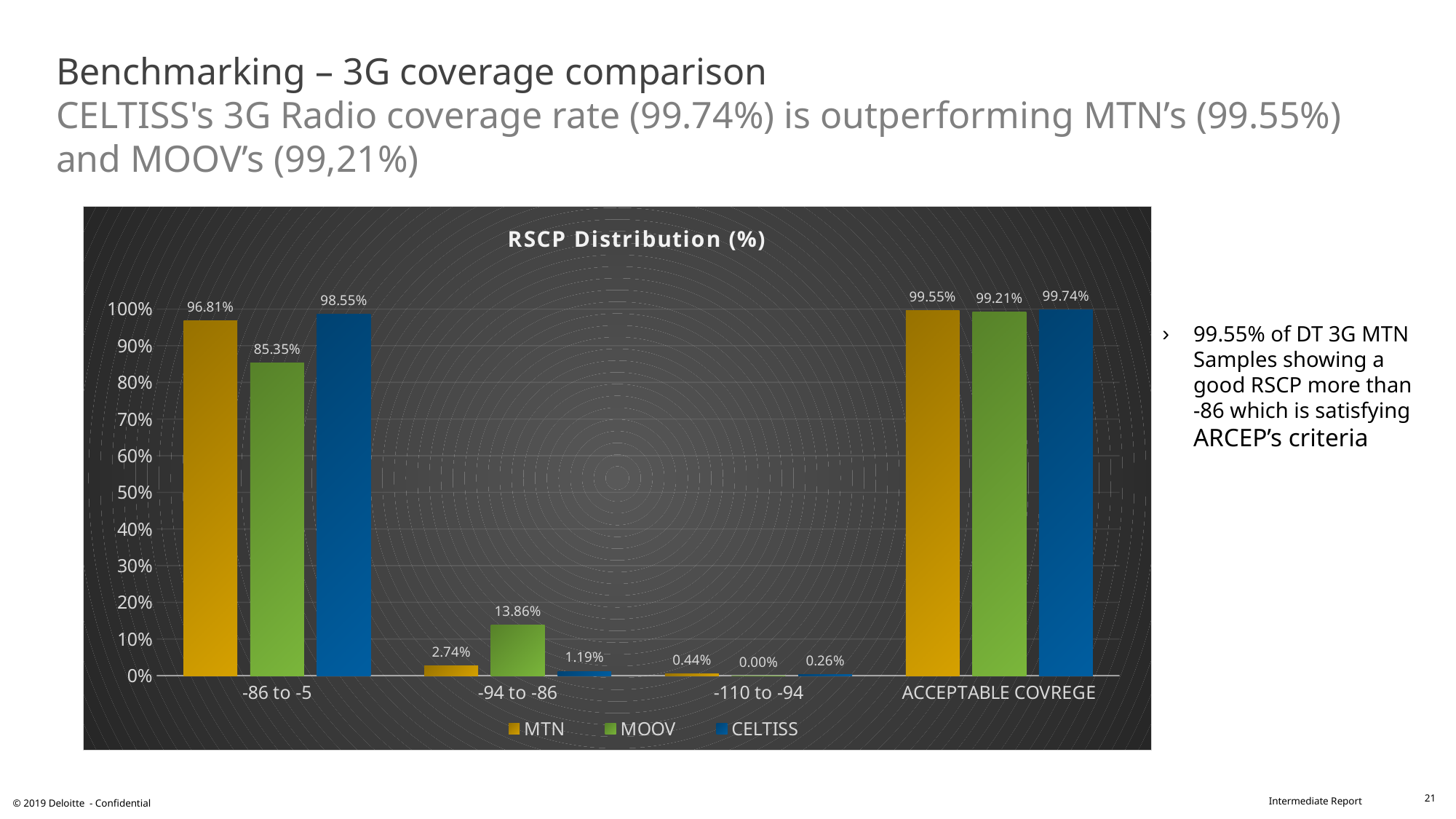
How many series does the legend list? 3 What is the MOOV value for the -86 to -5 category in the RSCP Distribution (%) chart? 85.35% How many categories are shown on the x axis of the chart? 4 What kind of chart is shown on the slide? Bar chart What is the CELTISS value for ACCEPTABLE COVREGE? 99.74% What is the difference between the CELTISS and MTN values in the -86 to -5 category? 1.74% Which series has the lowest value in the -86 to -5 category? MOOV Which series has the highest value in the -94 to -86 category? MOOV What is the title of the chart? RSCP Distribution (%) Which is larger in the -94 to -86 category, the MTN value or the CELTISS value? MTN What is the CELTISS value for the -94 to -86 category? 1.19% What is the MTN value for the -110 to -94 category? 0.44%